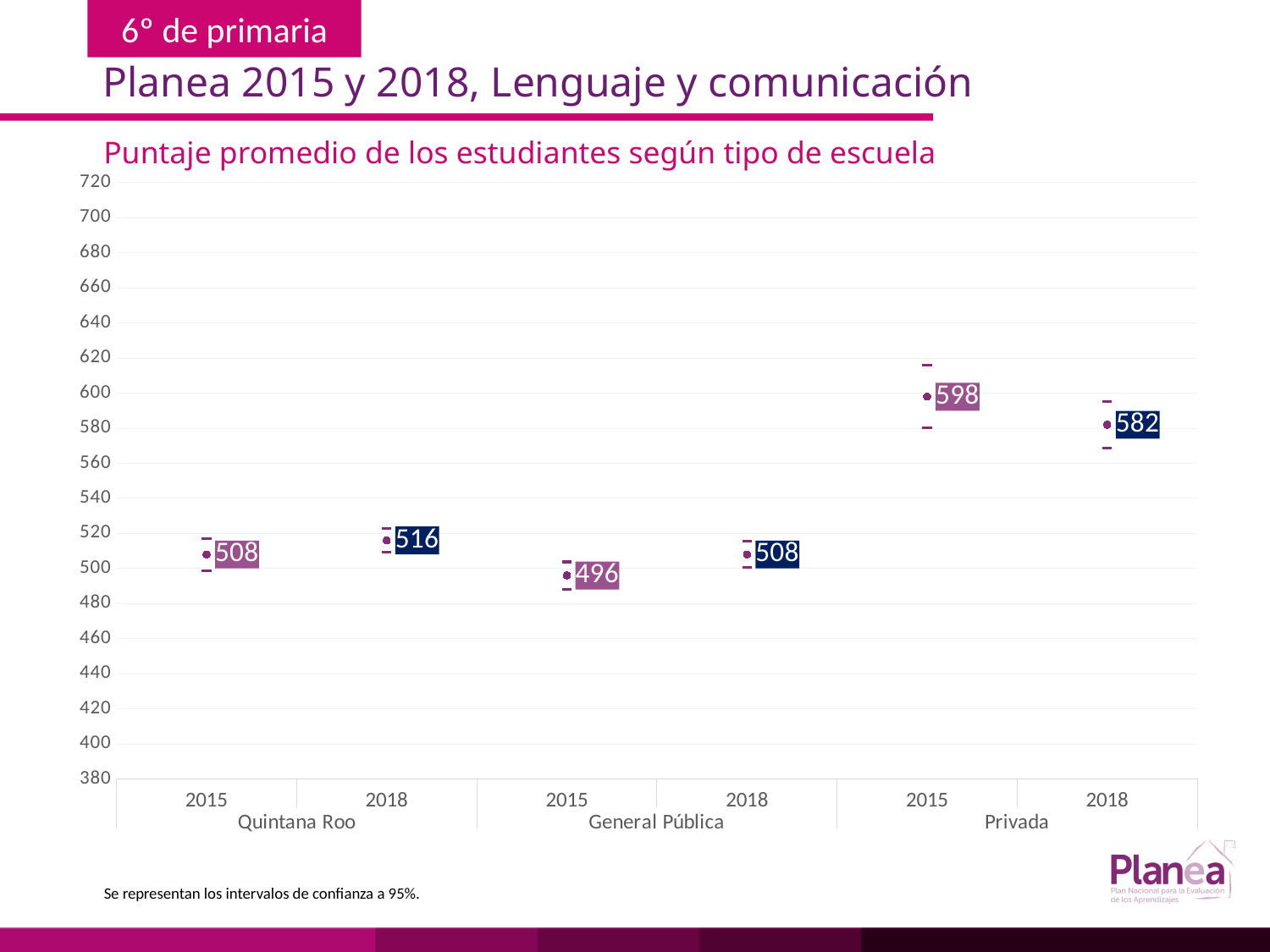
Did the Privada score rise or fall from 2015 to 2018? fall What is the average score for Privada in 2018? 582 What is the average score for Quintana Roo in 2015? 508 What is the average score for General Pública in 2015? 496 What is the title of the chart? Puntaje promedio de los estudiantes según tipo de escuela What is the difference between the Privada scores in 2015 and 2018? 16 Which school type and year has the highest average score? Privada 2015 What is the average score for Quintana Roo in 2018? 516 How many data points are plotted on the chart? 6 Which school type and year has the lowest average score? General Pública 2015 By how much did the General Pública score change from 2015 to 2018? 12 Which is larger, the Quintana Roo 2018 score or the General Pública 2018 score? Quintana Roo 2018